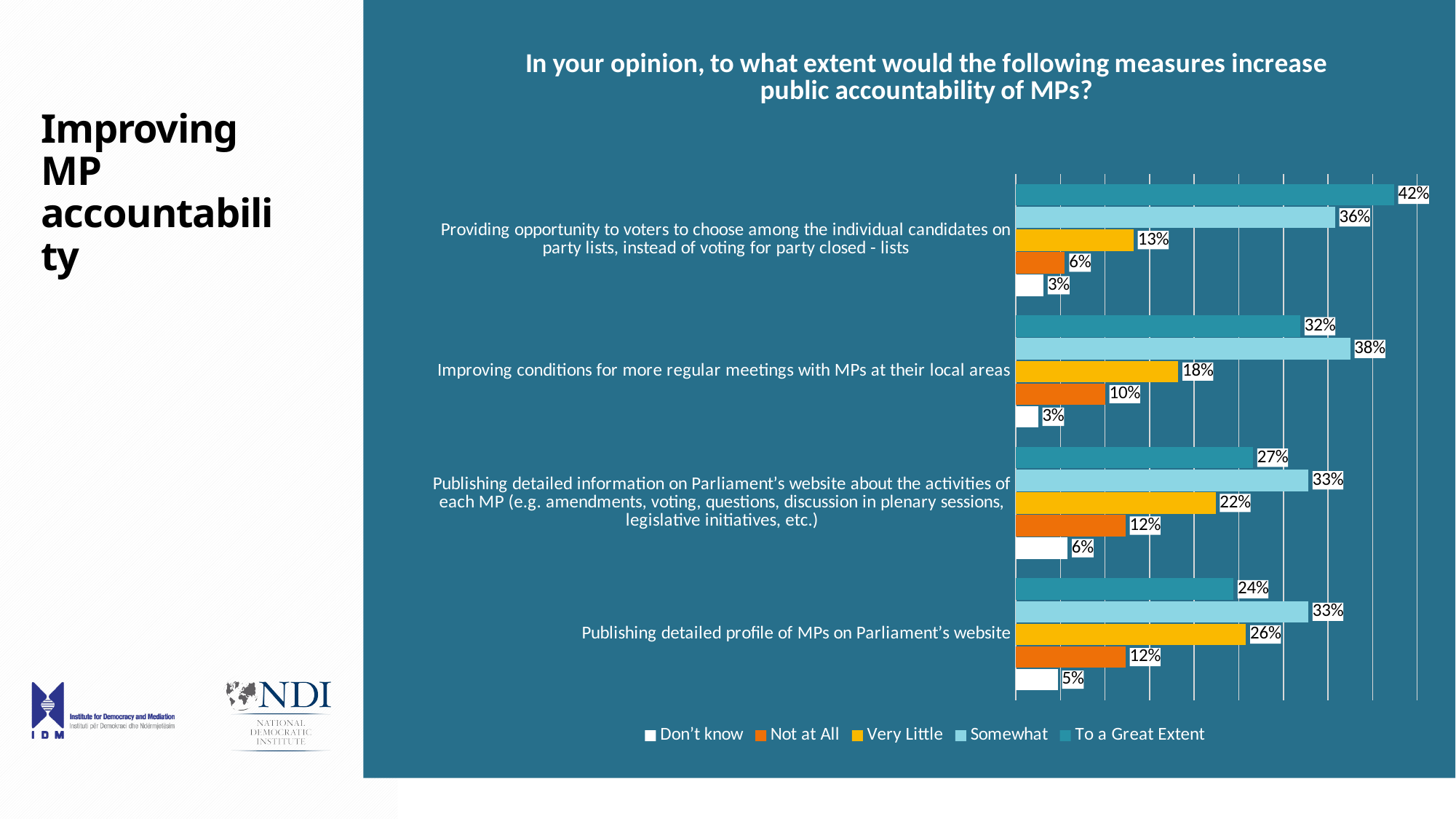
What is the 'Don't know' value for publishing detailed information on Parliament's website about the activities of each MP? 6% Which legend entry is shown in orange? Not at All How many measures (categories) are shown in the chart? 4 What is the 'Somewhat' value for improving conditions for more regular meetings with MPs at their local areas? 38% What percentage of respondents said providing opportunity to voters to choose among individual candidates on party lists would increase MP accountability 'To a Great Extent'? 42% What type of chart is shown on the slide? Bar chart Which measure has the lowest 'To a Great Extent' value? Publishing detailed profile of MPs on Parliament's website What is the 'Very Little' value for publishing detailed profile of MPs on Parliament's website? 26% How many series does the legend list? 5 What is the difference between the 'To a Great Extent' values for providing opportunity to voters to choose among individual candidates (42%) and publishing detailed profile of MPs (24%)? 18% For improving conditions for more regular meetings with MPs, which is larger: the 'Somewhat' value or the 'To a Great Extent' value? Somewhat Which measure has the highest 'To a Great Extent' value? Providing opportunity to voters to choose among the individual candidates on party lists, instead of voting for party closed - lists